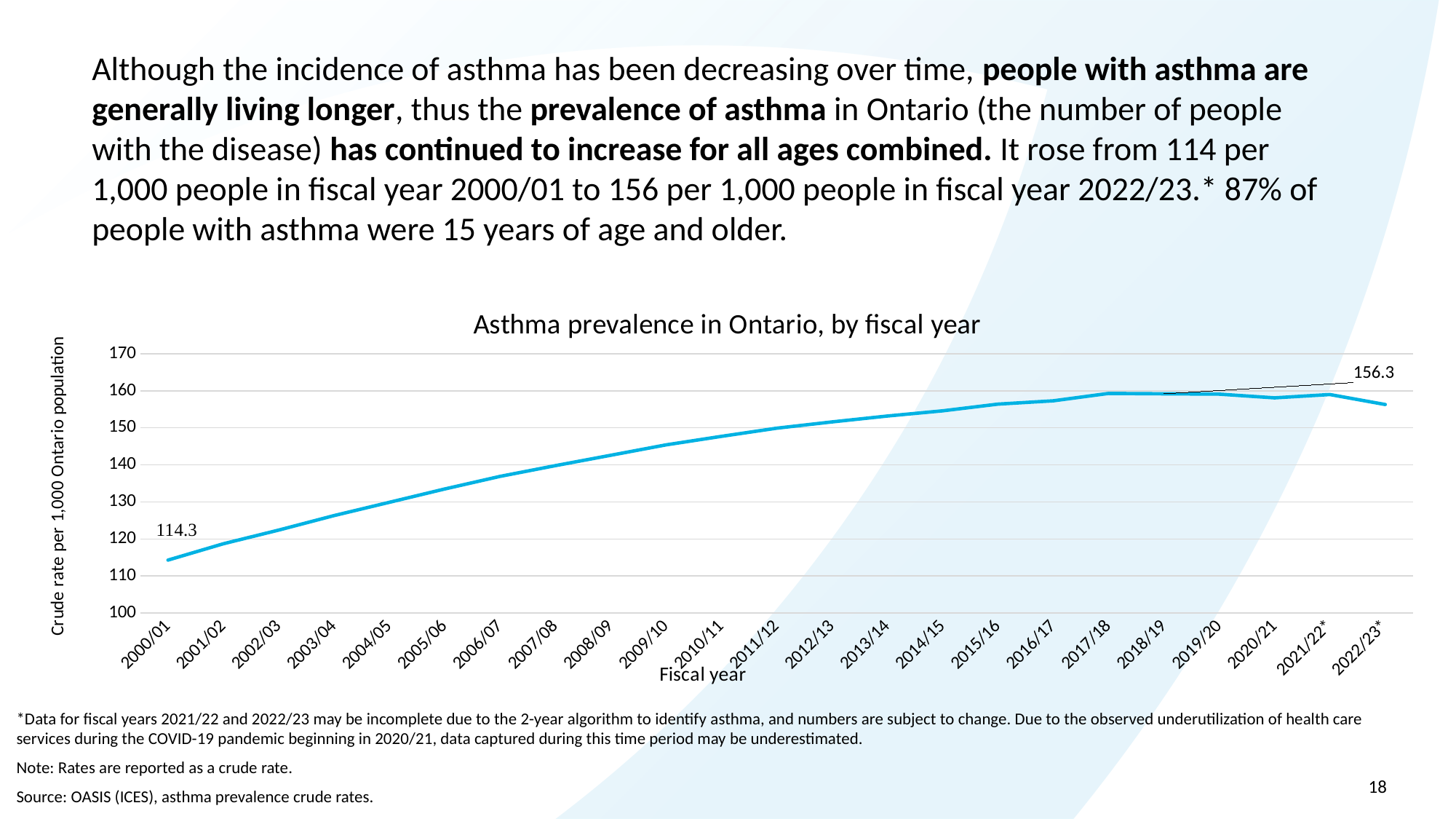
Is the value for 2015/16 greater or less than 150? greater What is the crude rate per 1,000 Ontario population for fiscal year 2022/23? 156.3 Is the value for 2005/06 greater or less than 130? greater Which fiscal year has the lowest asthma prevalence rate? 2000/01 Does the asthma prevalence rate generally rise or fall from 2000/01 to 2017/18? rise Is the value for 2010/11 greater or less than 150? less Which fiscal year has the larger rate, 2000/01 or 2022/23? 2022/23 What type of chart is shown on the slide? line chart What is the crude rate per 1,000 Ontario population for fiscal year 2000/01? 114.3 What is the title of the chart? Asthma prevalence in Ontario, by fiscal year What is the difference between the rate in 2022/23 and the rate in 2000/01? 42 How many fiscal years are plotted on the x axis? 23